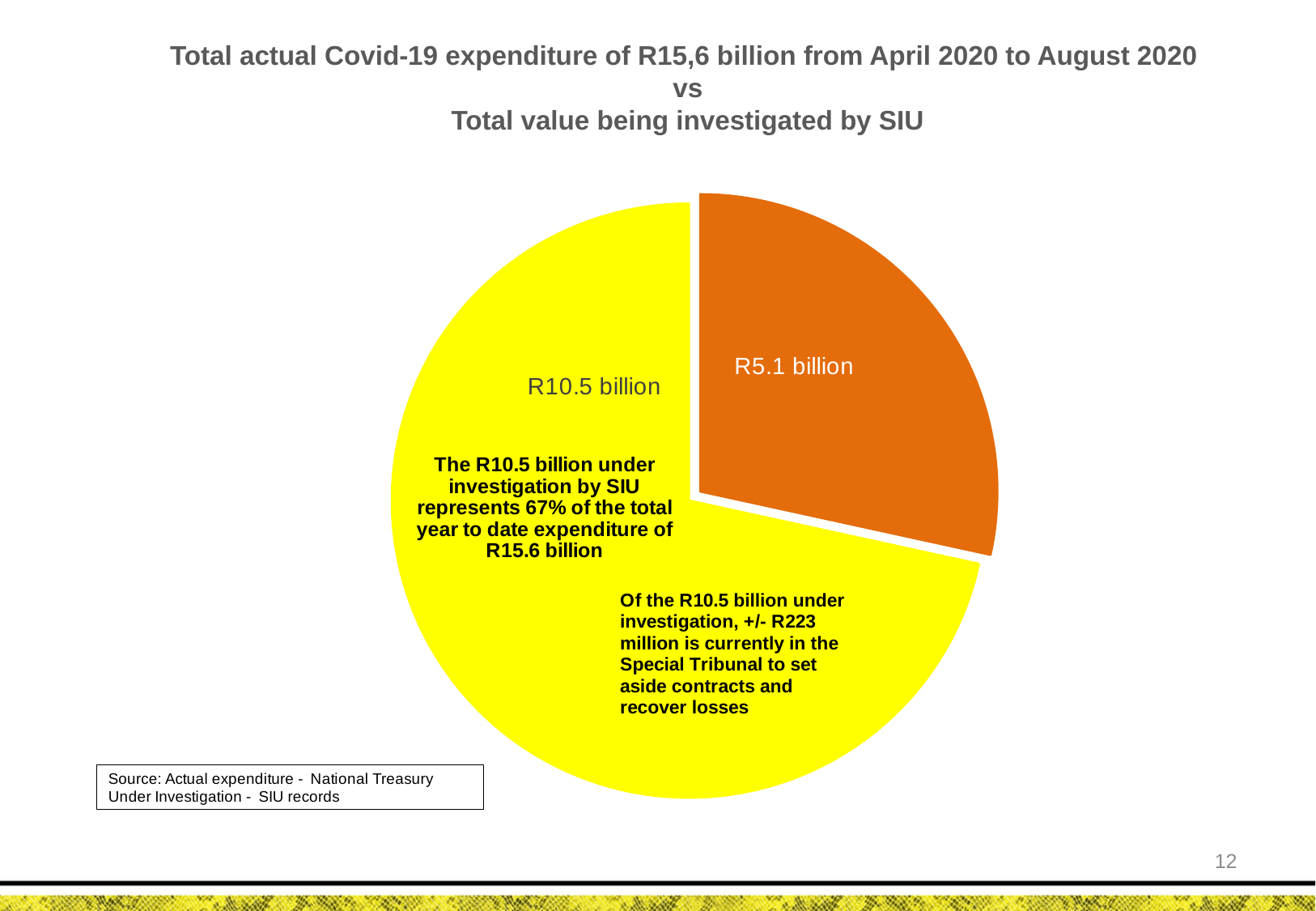
How many slices does the pie chart have? 2 What value is labelled on the yellow slice of the pie chart? R10.5 billion Which is larger: the yellow slice or the orange slice? the yellow slice What is the total of the two slices in the pie chart? R15.6 billion What is the difference between the R10.5 billion slice and the R5.1 billion slice? R5.4 billion What value is labelled on the orange slice of the pie chart? R5.1 billion Which slice of the pie chart is the smallest? R5.1 billion According to the source note, where does the actual expenditure data come from? National Treasury Which slice of the pie chart is the largest? R10.5 billion What colour is the slice representing the amount under investigation by SIU? yellow What kind of chart is shown on the slide? pie chart According to the slide, what share of the total expenditure does the R10.5 billion under investigation by SIU represent? 67%